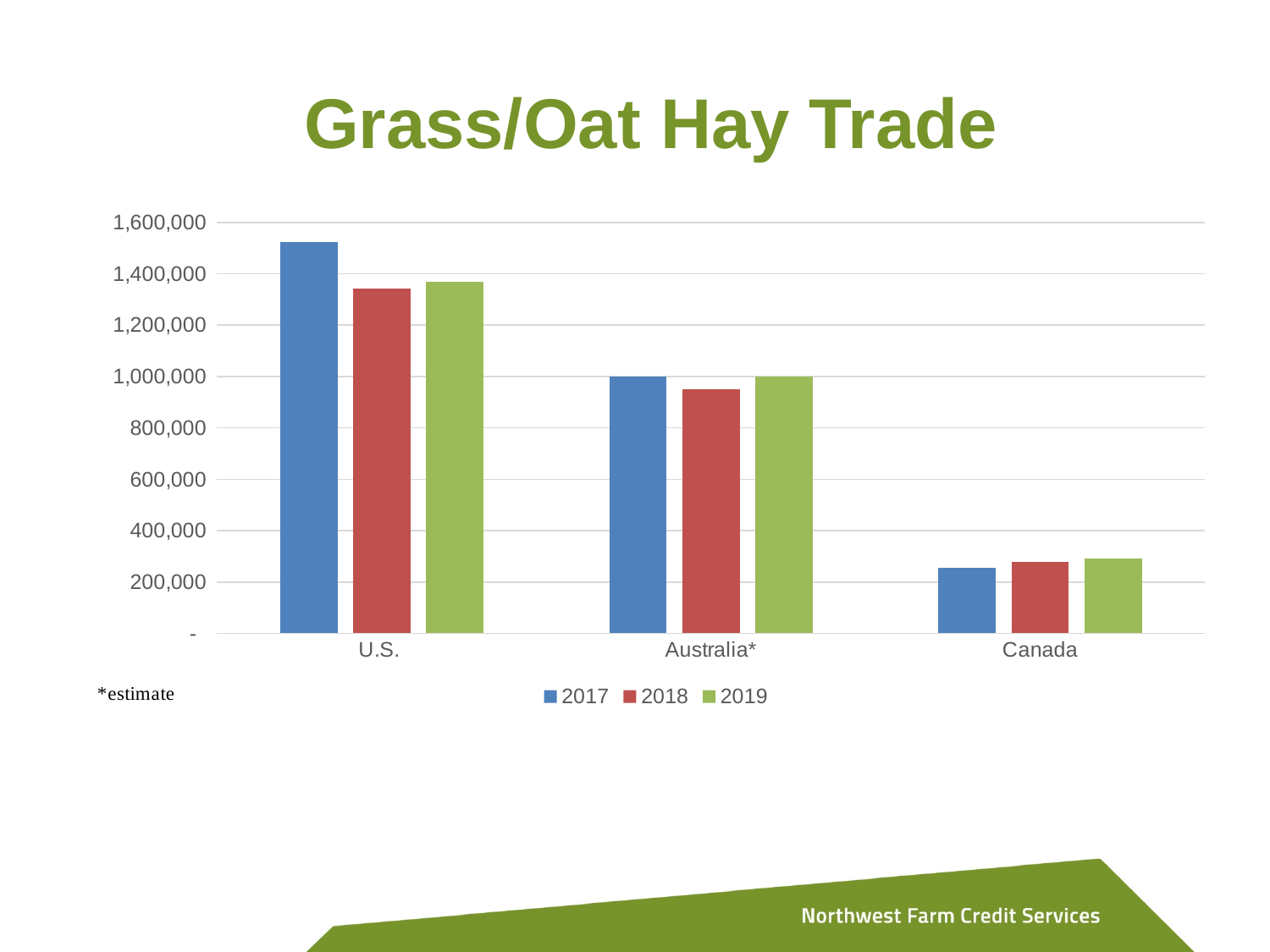
How many countries are shown on the x axis? 3 Do the 2017 values rise or fall moving from U.S. to Canada along the x axis? fall Which country has the lowest value for 2019? Canada What is the title of the chart? Grass/Oat Hay Trade Is the value for Australia* in 2018 greater or less than 1,000,000? less For Canada, which year has the larger value, 2017 or 2019? 2019 Is the value for the U.S. in 2017 greater or less than 1,400,000? greater What kind of chart is shown on the slide? bar chart How many series does the legend list? 3 Which country has the highest value for 2017? U.S. Is the value for Canada in 2018 greater or less than 400,000? less For the U.S., which year has the larger value, 2017 or 2018? 2017